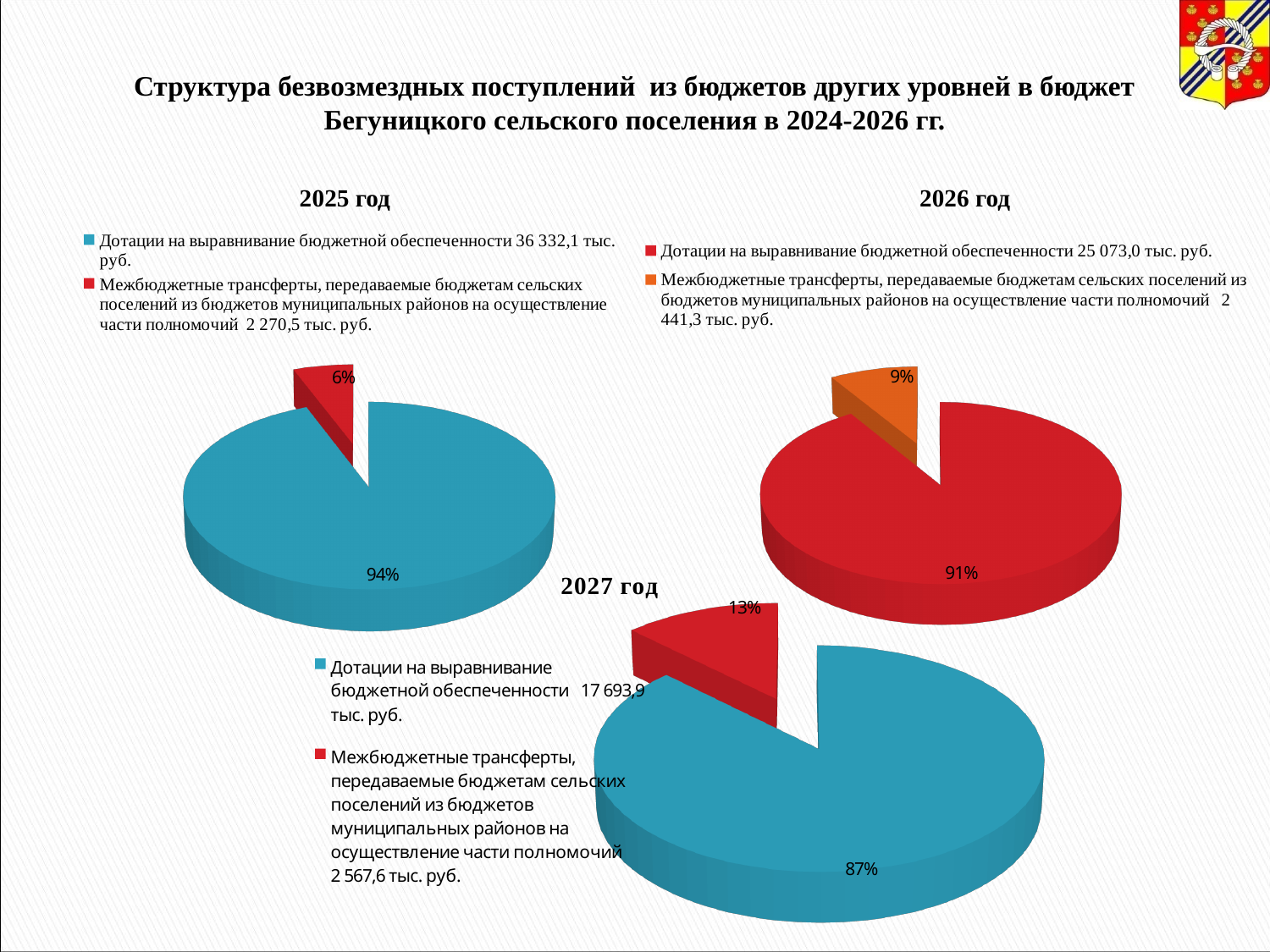
In the "2025 год" chart, what share of the pie is labelled for Дотации на выравнивание бюджетной обеспеченности? 94% In the "2026 год" chart, what share of the pie is labelled for Дотации на выравнивание бюджетной обеспеченности? 91% In the "2025 год" chart, which slice is the largest? Дотации на выравнивание бюджетной обеспеченности In the "2027 год" chart, what share of the pie is labelled for Дотации на выравнивание бюджетной обеспеченности? 87% In the "2025 год" chart, what value does the legend give for Дотации на выравнивание бюджетной обеспеченности? 36 332,1 тыс. руб. What kind of chart is the "2026 год" chart? Pie chart How many slices does the "2027 год" chart have? 2 In the "2026 год" chart, what value does the legend give for Межбюджетные трансферты? 2 441,3 тыс. руб. In the "2027 год" chart, what value does the legend give for Дотации на выравнивание бюджетной обеспеченности? 17 693,9 тыс. руб.